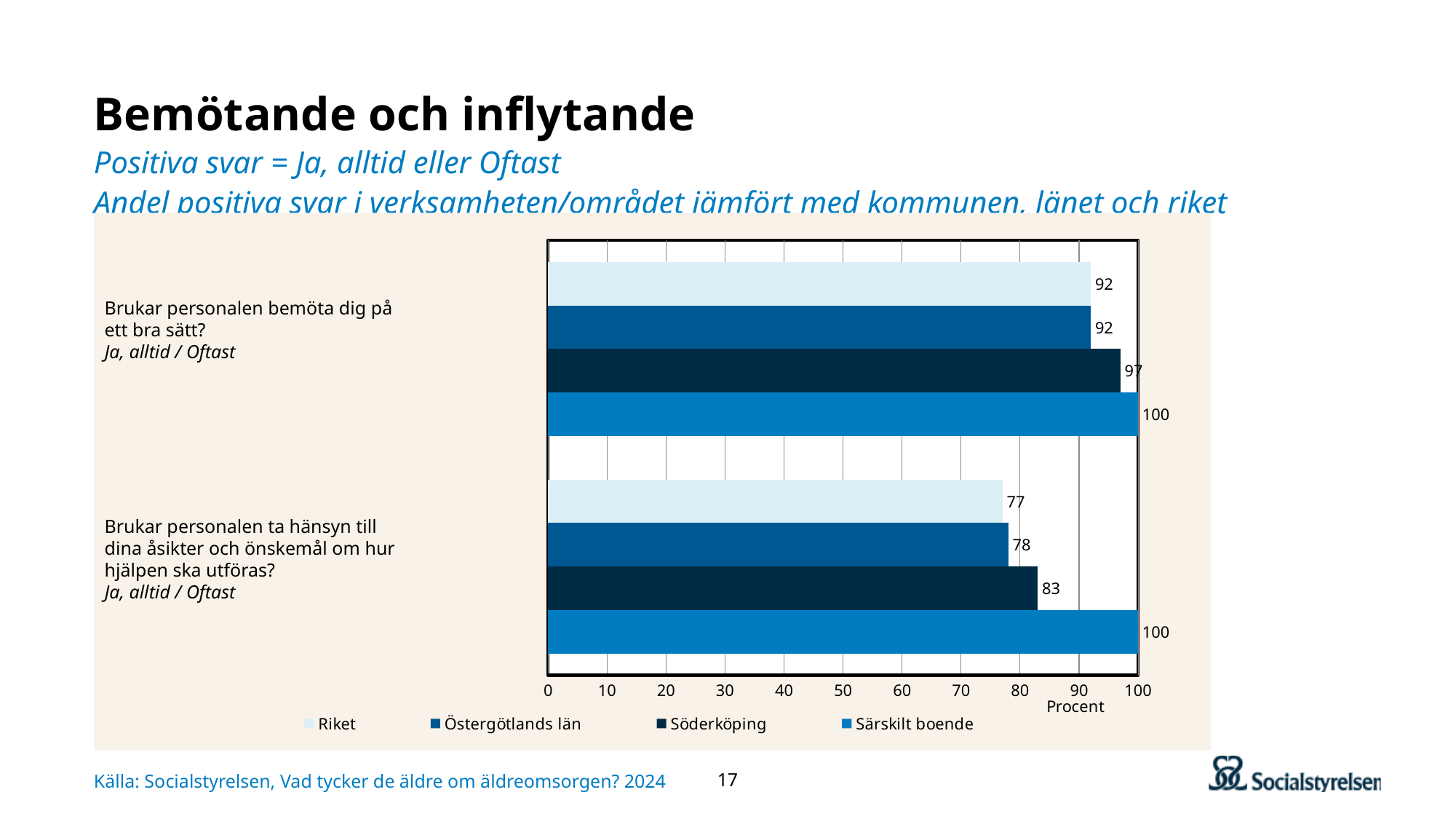
Which series has the highest value on the question "Brukar personalen bemöta dig på ett bra sätt?" Särskilt boende Which is larger on the question "Brukar personalen ta hänsyn till dina åsikter och önskemål om hur hjälpen ska utföras?": Söderköping or Östergötlands län? Söderköping What is the difference between Särskilt boende and Söderköping on the question "Brukar personalen ta hänsyn till dina åsikter och önskemål om hur hjälpen ska utföras?" 17 What unit is shown on the horizontal axis of the chart? Procent What is the value for Riket on the question "Brukar personalen ta hänsyn till dina åsikter och önskemål om hur hjälpen ska utföras?" 77 How many series does the legend list? 4 What is the value for Östergötlands län on the question "Brukar personalen bemöta dig på ett bra sätt?" 92 What is the difference between Söderköping and Riket on the question "Brukar personalen bemöta dig på ett bra sätt?" 5 What kind of chart is shown on the slide? Bar chart What is the value for Särskilt boende on the question "Brukar personalen bemöta dig på ett bra sätt?" 100 Which series has the lowest value on the question "Brukar personalen ta hänsyn till dina åsikter och önskemål om hur hjälpen ska utföras?" Riket What is the value for Söderköping on the question "Brukar personalen ta hänsyn till dina åsikter och önskemål om hur hjälpen ska utföras?" 83